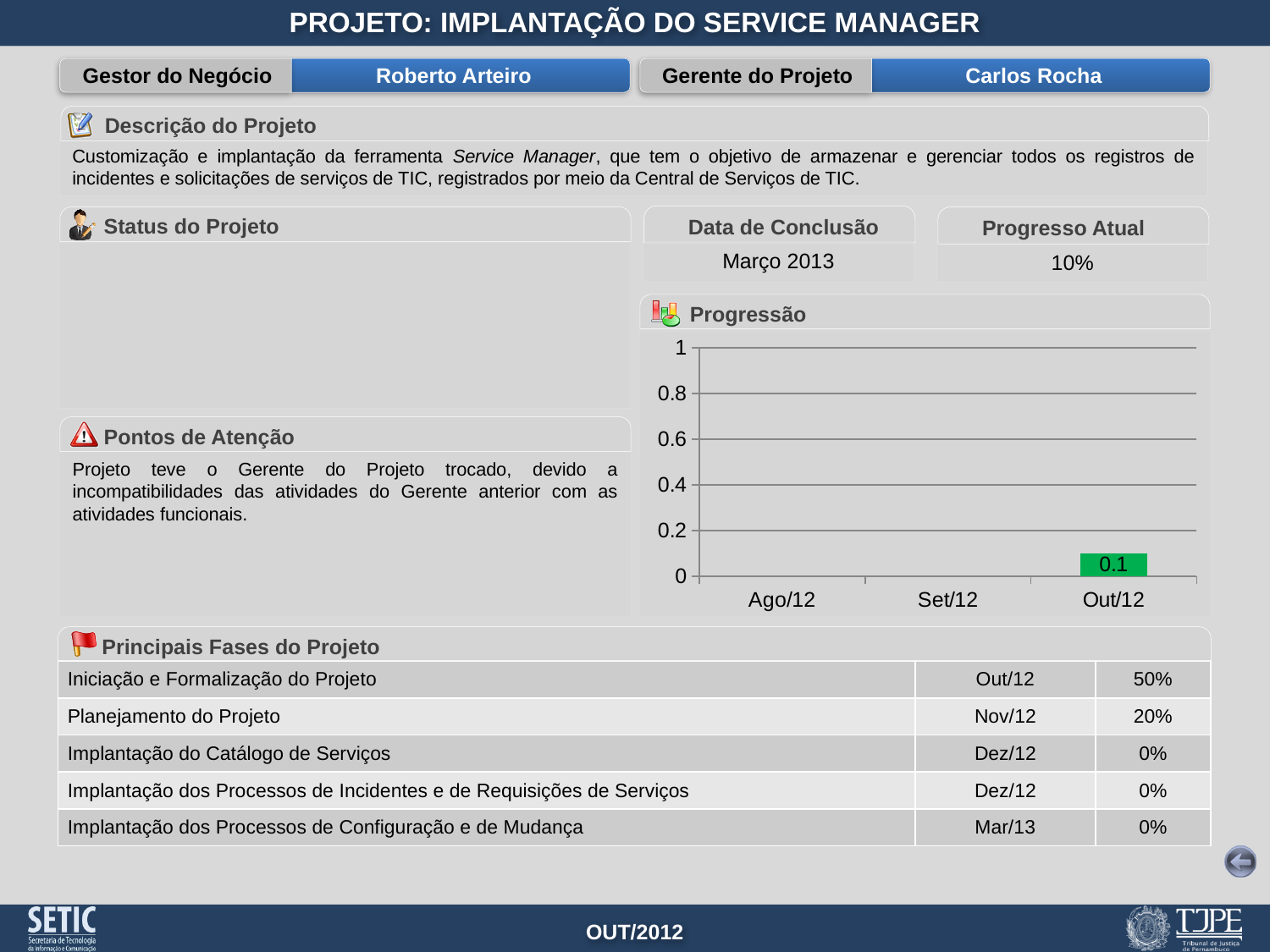
In the Progressão chart, what is the value for Out/12? 0.1 What kind of chart is the Progressão chart? bar chart In the Progressão chart, is the value for Out/12 greater or less than 0.2? less In the Progressão chart, which is larger, the value for Ago/12 or the value for Out/12? Out/12 What is the highest value shown on the y axis of the Progressão chart? 1 How many categories are shown on the x axis of the Progressão chart? 3 What colour is the bar for Out/12 in the Progressão chart? green Do the values in the Progressão chart rise or fall from Ago/12 to Out/12? rise Which category has the highest value in the Progressão chart? Out/12 What is the title of the chart on the slide? Progressão